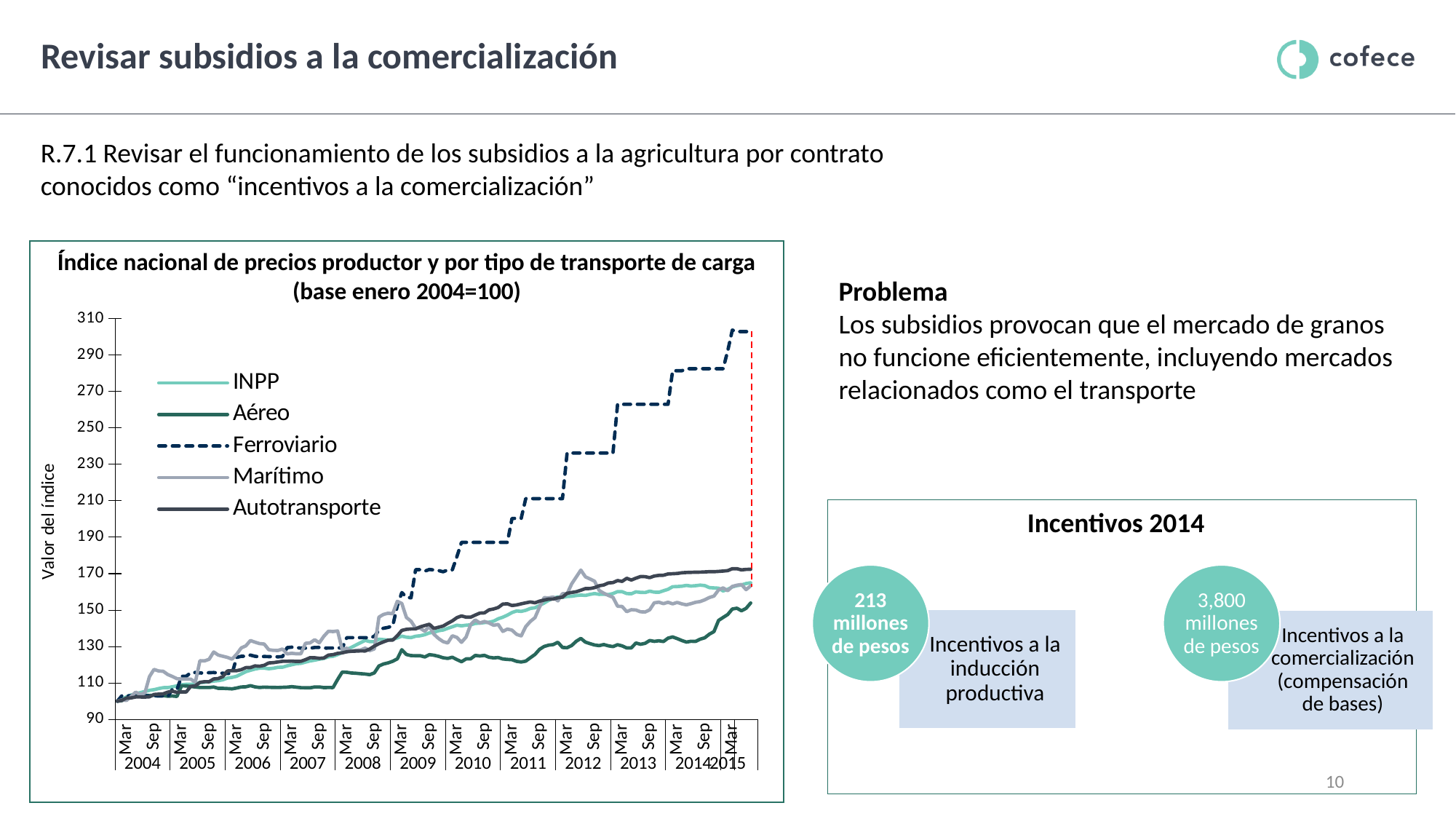
Is the value for Ferroviario in 2015 greater or less than 290? greater Which series has the lowest value at the end of the chart (2015)? Aéreo Is the value for Autotransporte in 2015 greater or less than 150? greater What is the title of the chart? Índice nacional de precios productor y por tipo de transporte de carga (base enero 2004=100) What kind of chart is shown on the slide? line chart Which series is higher in 2015, Ferroviario or Aéreo? Ferroviario Which series has the highest value at the end of the chart (2015)? Ferroviario How many series does the chart legend list? 5 Which series are listed in the chart legend? INPP, Aéreo, Ferroviario, Marítimo, Autotransporte Does the Ferroviario series rise or fall from 2004 to 2015? rise Is the value for Aéreo in 2015 greater or less than 170? less How many years are labelled on the x axis of the chart? 12